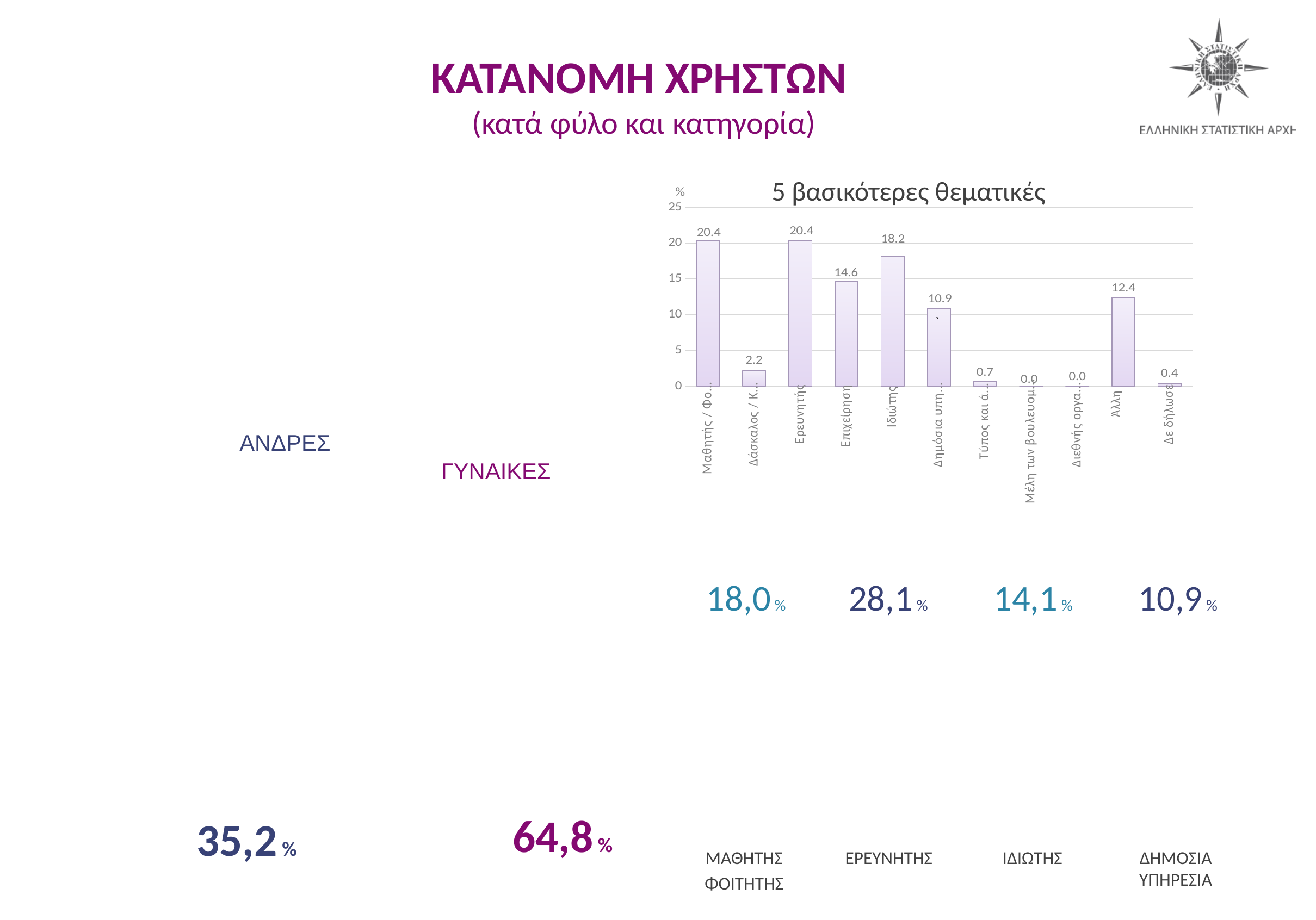
What is the difference between the values for Άλλη and Δε δήλωσε? 12.0 What is the title of the chart? 5 βασικότερες θεματικές What is the value for Άλλη in the chart? 12.4 Is the value for Ερευνητής greater or less than 15? greater What is the value for Ιδιώτης in the chart? 18.2 Which is larger in the chart, Ιδιώτης or Επιχείρηση? Ιδιώτης What is the value for Επιχείρηση in the chart? 14.6 What is the value for Ερευνητής in the chart? 20.4 What is the difference between the values for Ιδιώτης and Επιχείρηση? 3.6 What is the value for Δε δήλωσε in the chart? 0.4 How many categories are shown on the x axis of the chart? 11 What kind of chart is shown on the slide? bar chart